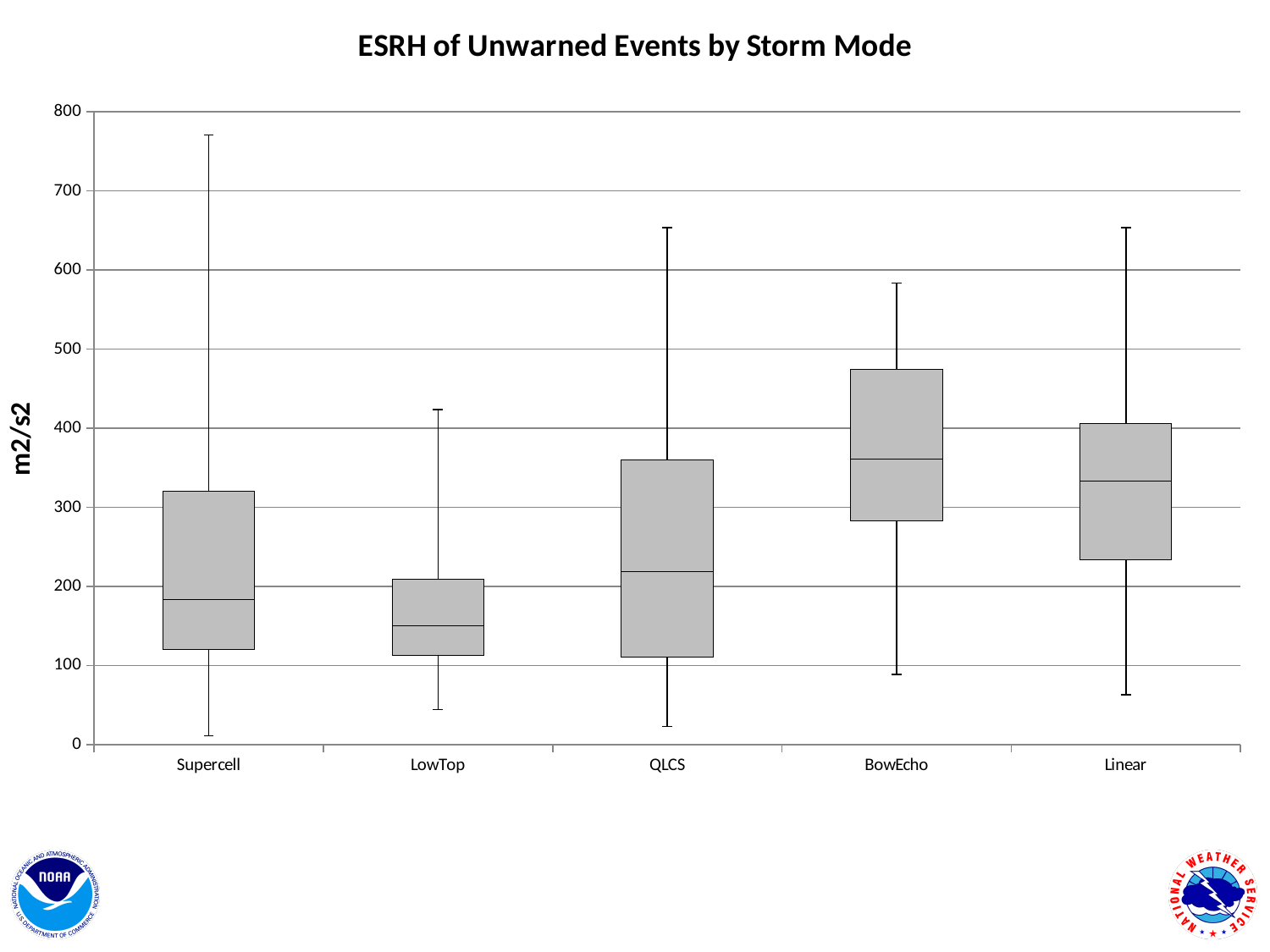
Is the upper whisker for Supercell greater or less than 700? greater Which storm mode has the lowest median ESRH? LowTop Is the median value for BowEcho greater or less than 300? greater Which has the larger median ESRH, QLCS or Linear? Linear Is the top of the box (upper quartile) for BowEcho greater or less than 500? less What kind of chart is shown on the slide? Box-and-whisker plot What is the label on the y axis? m2/s2 How many storm modes are shown on the x axis? 5 What is the title of the chart? ESRH of Unwarned Events by Storm Mode Which storm mode has the highest upper whisker (maximum value)? Supercell Which storm mode has the highest median ESRH? BowEcho